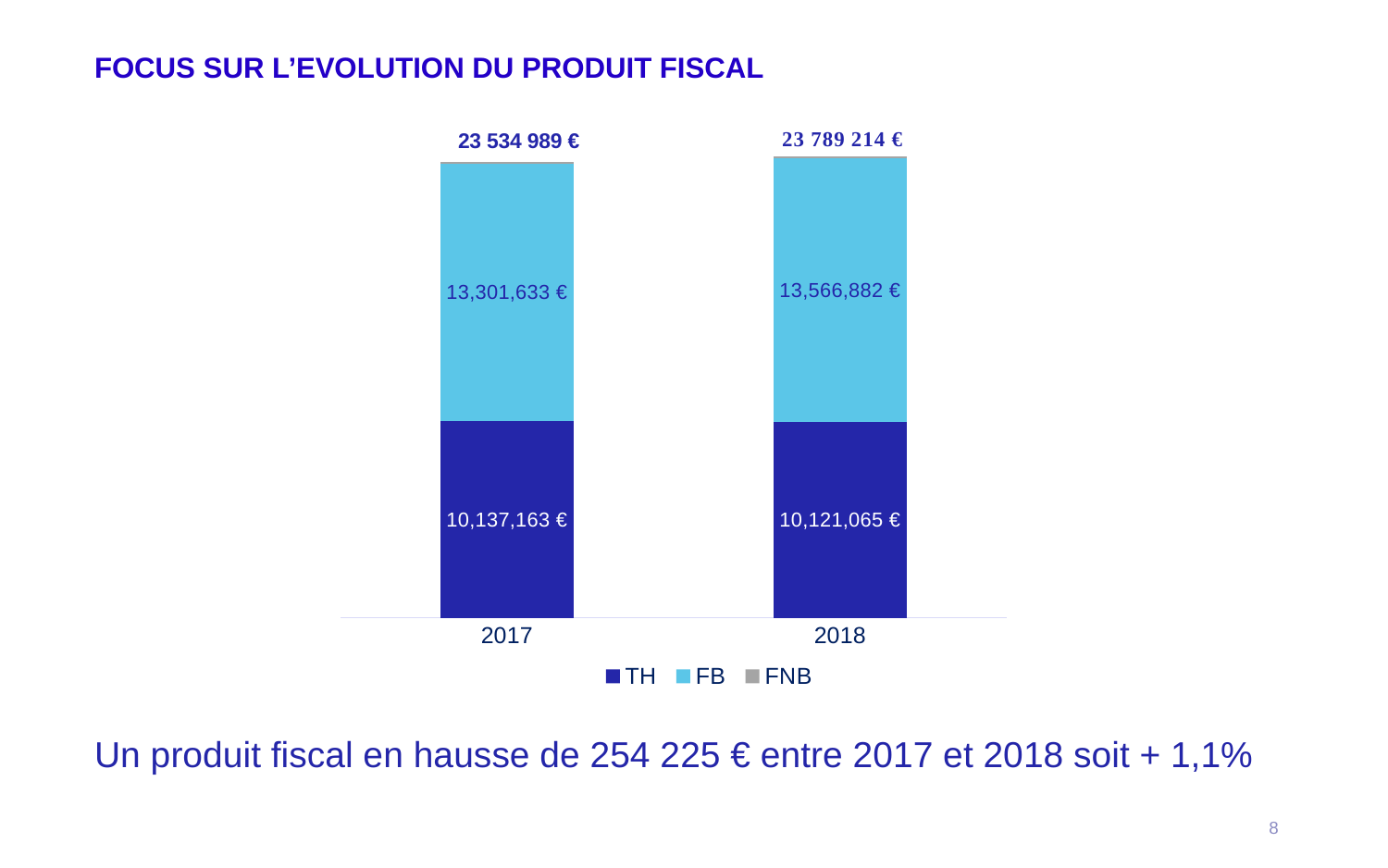
How many categories are shown on the x axis? 2 What is the total printed above the 2018 stacked bar? 23 789 214 € What is the total printed above the 2017 stacked bar? 23 534 989 € What kind of chart is shown on the slide? Stacked bar chart What is the value of the TH series for 2018? 10,121,065 € What is the value of the TH series for 2017? 10,137,163 € Which series has the larger value in 2018, TH or FB? FB What is the difference between the FB value in 2018 and the FB value in 2017? 265,249 € How many series does the legend list? 3 What is the value of the FB series for 2018? 13,566,882 € What is the difference between the TH value in 2017 and the TH value in 2018? 16,098 € Does the total of the stacked bar rise or fall from 2017 to 2018? Rise